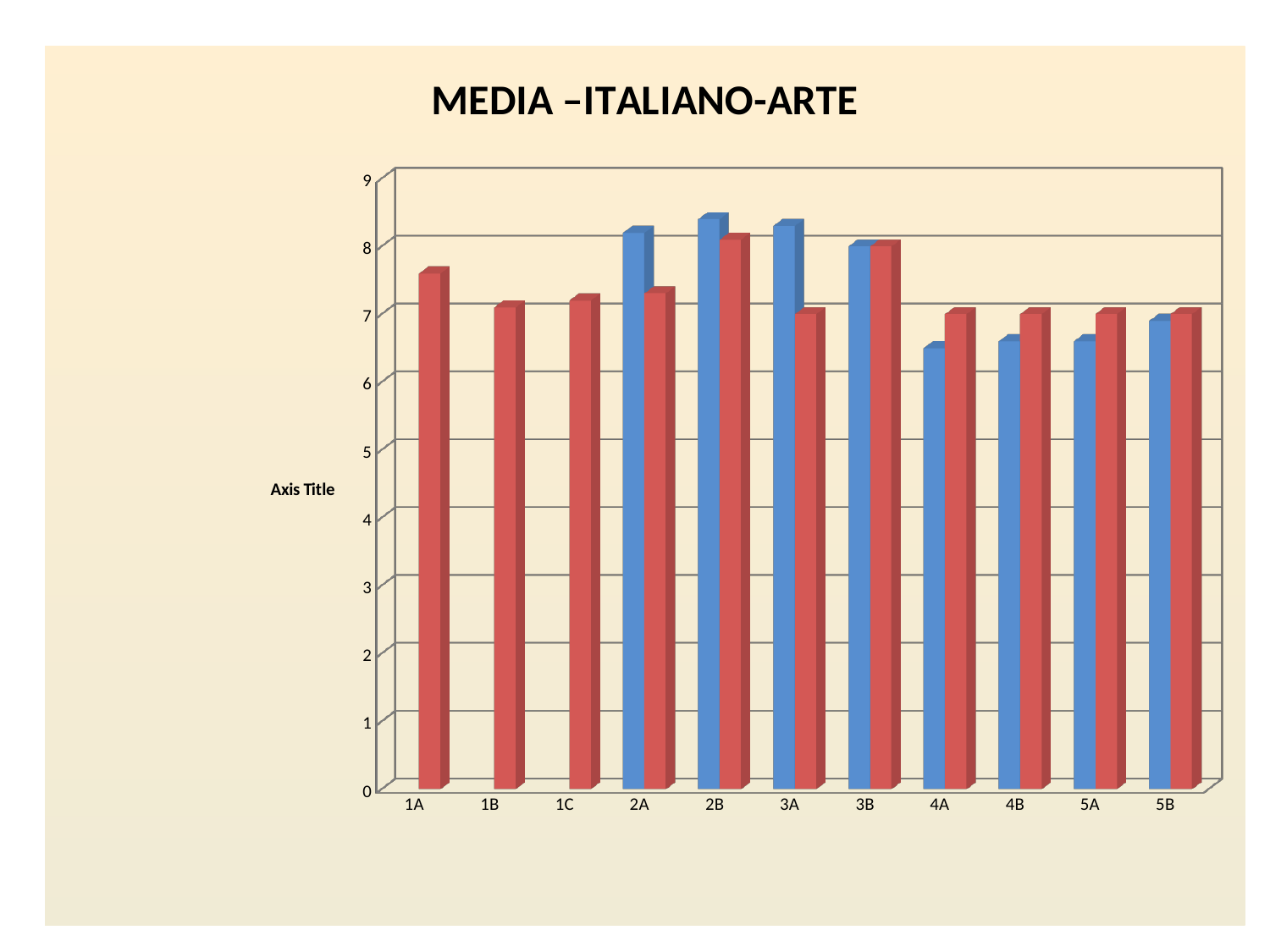
Is the red bar for 1A greater or less than 7? greater Is the blue bar for 4A greater or less than 7? less Which red bar is taller, 1A or 1B? 1A Is the red bar for 1A greater or less than 8? less What is the title of the chart? MEDIA –ITALIANO-ARTE What type of chart is shown on the slide? Bar chart For category 2A, which bar is taller, the blue one or the red one? Blue How many categories are shown on the x axis? 11 What label is shown on the vertical axis? Axis Title For category 4A, which bar is taller, the blue one or the red one? Red